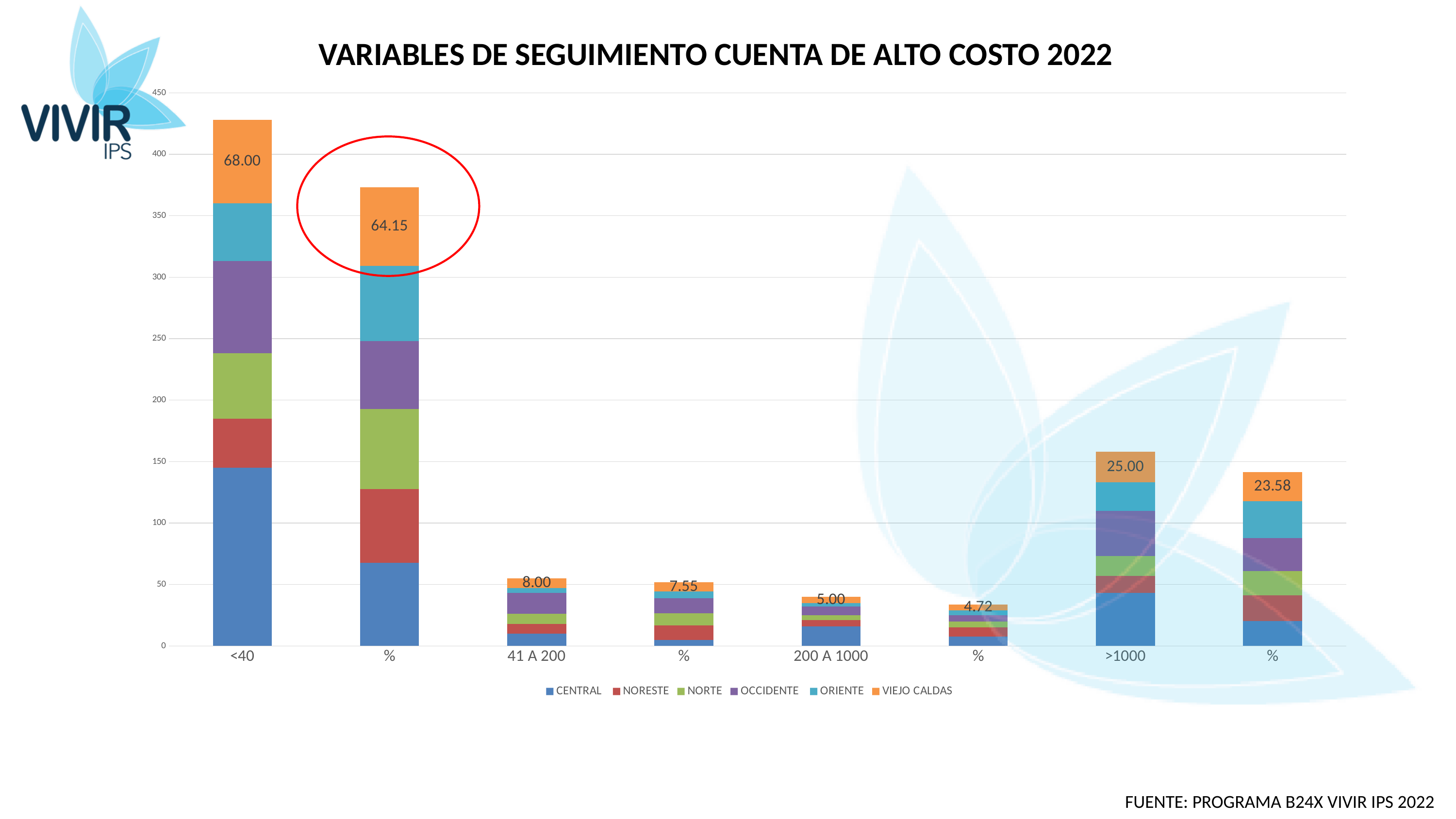
Is the total height of the <40 stacked bar greater or less than 400? greater How many stacked bars are plotted along the x axis? 8 What is the VIEJO CALDAS value labelled on the circled bar (the % bar immediately right of <40)? 64.15 What is the VIEJO CALDAS value labelled on the 41 A 200 bar? 8.00 What is the VIEJO CALDAS value labelled on the >1000 bar? 25.00 Which category has the highest labelled VIEJO CALDAS value? <40 What is the difference between the VIEJO CALDAS labels on the <40 bar and the >1000 bar? 43.00 What is the VIEJO CALDAS value labelled on the 200 A 1000 bar? 5.00 What is the title of the chart? VARIABLES DE SEGUIMIENTO CUENTA DE ALTO COSTO 2022 What kind of chart is shown on the slide? bar chart What is the VIEJO CALDAS value labelled on the <40 bar? 68.00 How many series does the legend list? 6